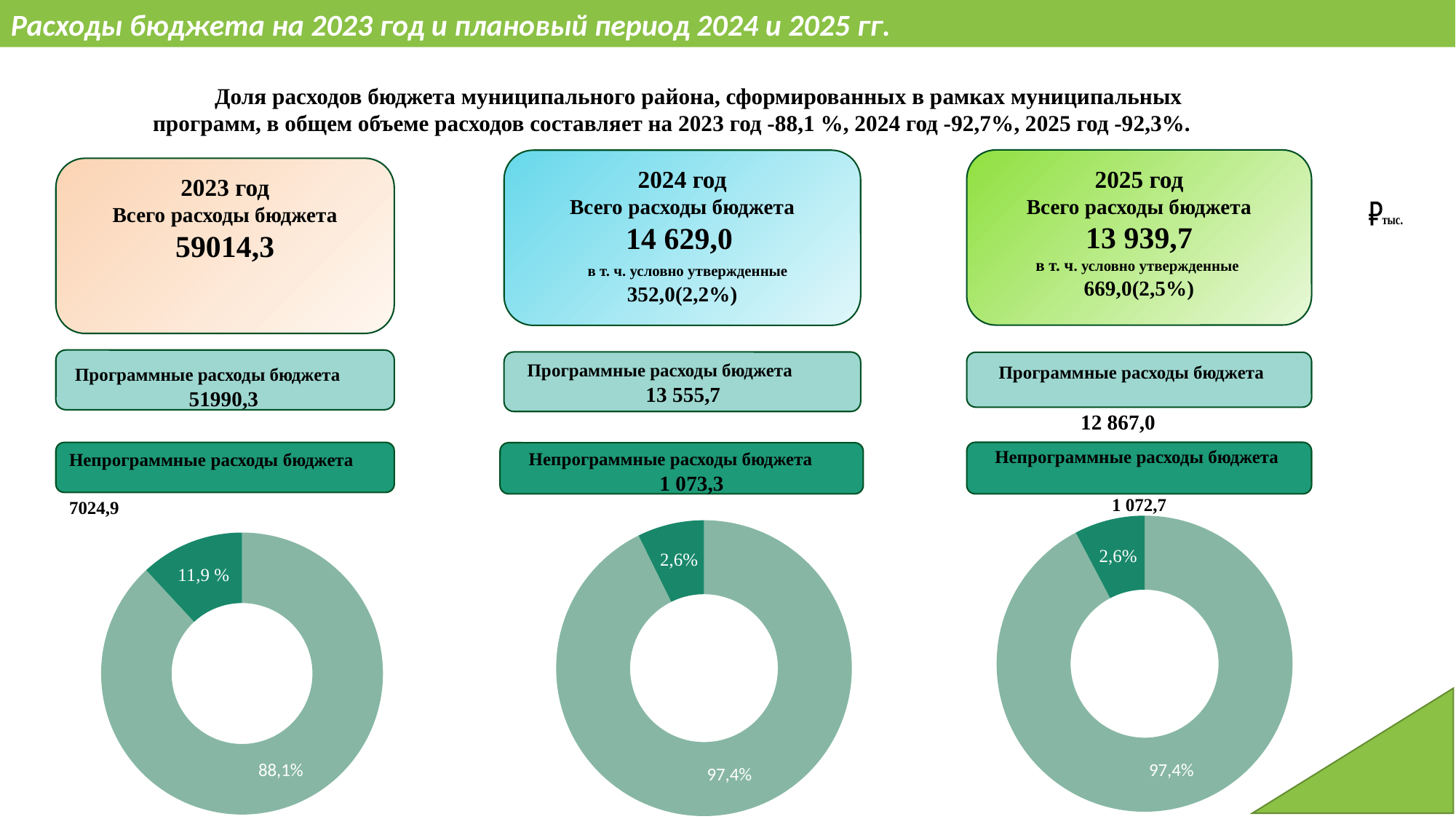
What kind of chart is shown under the 2023 column on the left? Donut (pie) chart In the middle donut chart (2024), what percentage is shown for the large light-green slice? 97,4% How many donut charts are shown on the slide? 3 In the left donut chart (2023), what percentage is shown for the large light-green slice? 88,1% In the left donut chart (2023), what is the difference between the two slice percentages, 88,1% and 11,9 %? 76,2% In the left donut chart (2023), what percentage is shown for the small dark-green slice? 11,9 % In the right donut chart (2025), what percentage is shown for the large light-green slice? 97,4% In the left donut chart (2023), which slice is larger: the light-green one or the dark-green one? The light-green one In the middle donut chart (2024), what percentage is shown for the small dark-green slice? 2,6% How many slices does the left donut chart (2023) have? 2 In the right donut chart (2025), is the dark-green slice greater or less than 10%? less Which of the three donut charts has the largest dark-green slice? The 2023 chart (left)